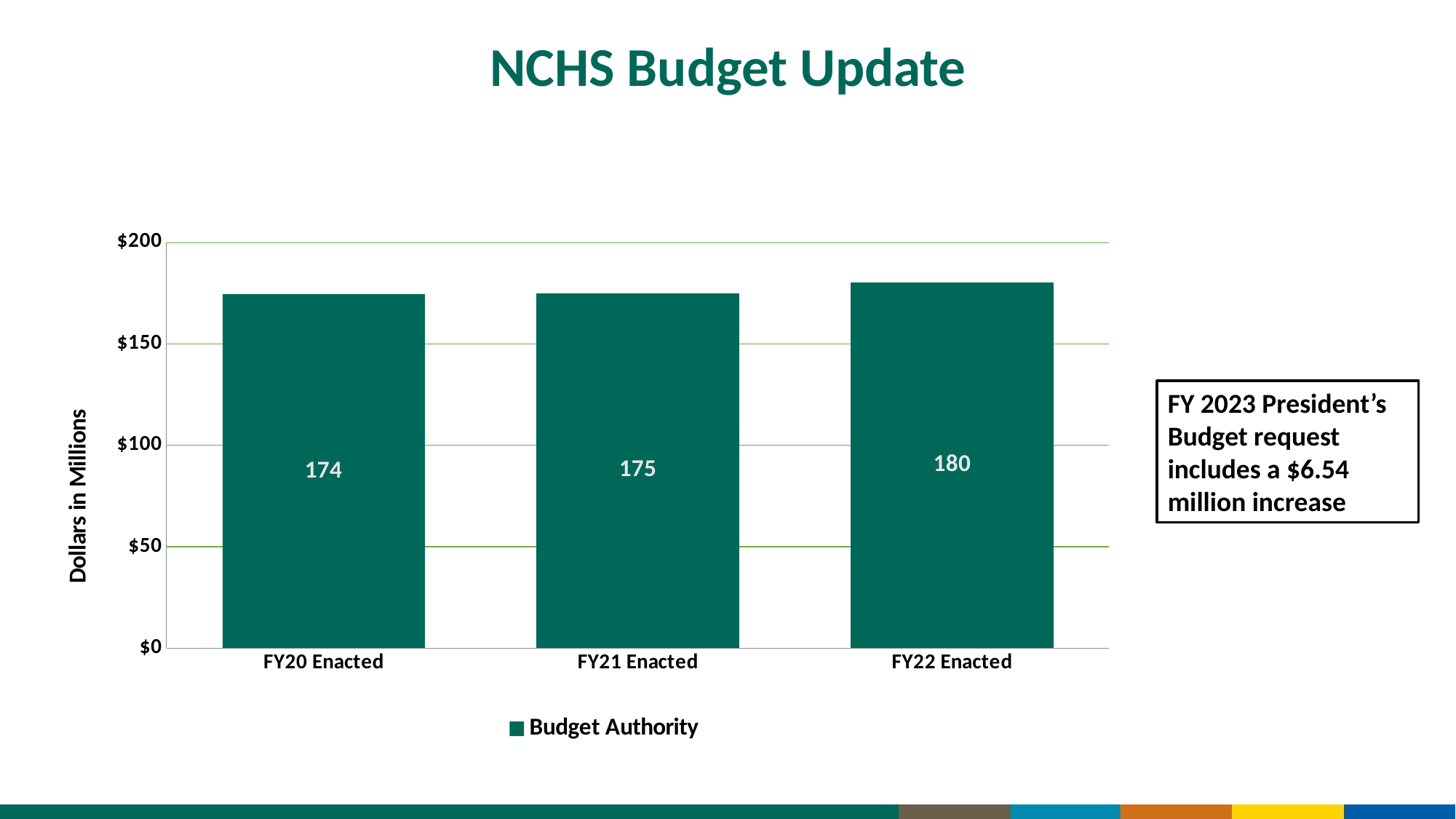
What kind of chart is shown on the slide? bar chart Which fiscal year has the lowest Budget Authority? FY20 Enacted Which fiscal year has the highest Budget Authority? FY22 Enacted What is the difference between the FY22 Enacted and FY21 Enacted values? 5 How many series does the legend list? 1 What is the Budget Authority value for FY22 Enacted? 180 What is the Budget Authority value for FY20 Enacted? 174 How many categories are shown on the x axis? 3 Do the Budget Authority values rise or fall from FY20 Enacted to FY22 Enacted? rise What is the difference between the FY22 Enacted and FY20 Enacted values? 6 What is the Budget Authority value for FY21 Enacted? 175 Is the value for FY22 Enacted greater or less than $150? greater